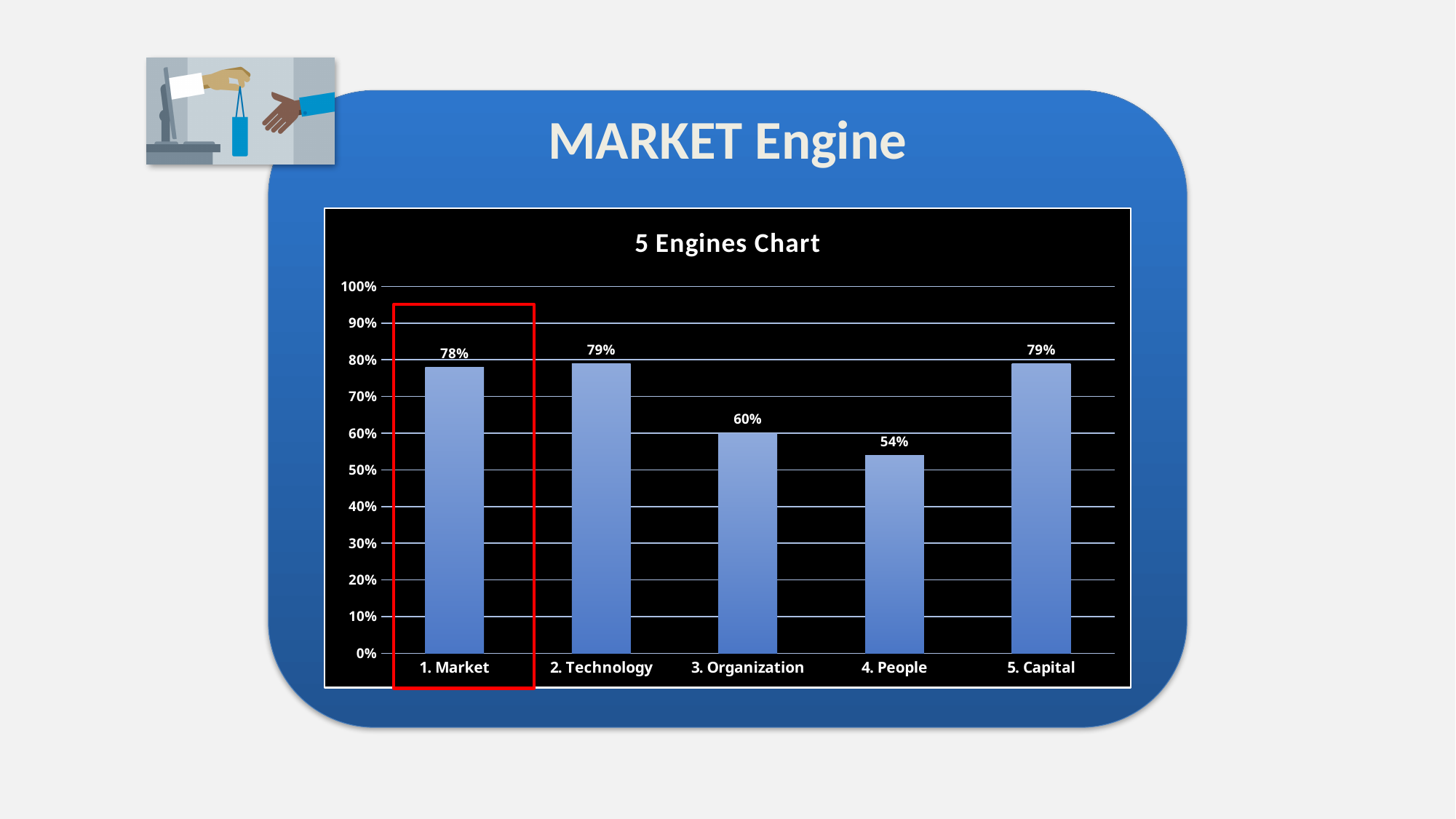
Which is larger, the value for 3. Organization or the value for 4. People? 3. Organization What is the title of the chart? 5 Engines Chart How many categories are shown on the x axis? 5 What is the value for 3. Organization? 60% What is the value for 1. Market? 78% What is the difference between the values for 2. Technology and 4. People? 25% What kind of chart is shown? bar chart What is the value for 5. Capital? 79% What is the value for 4. People? 54% Is the value for 4. People greater or less than 60%? less Which category has the lowest value? 4. People What is the difference between the values for 1. Market and 3. Organization? 18%